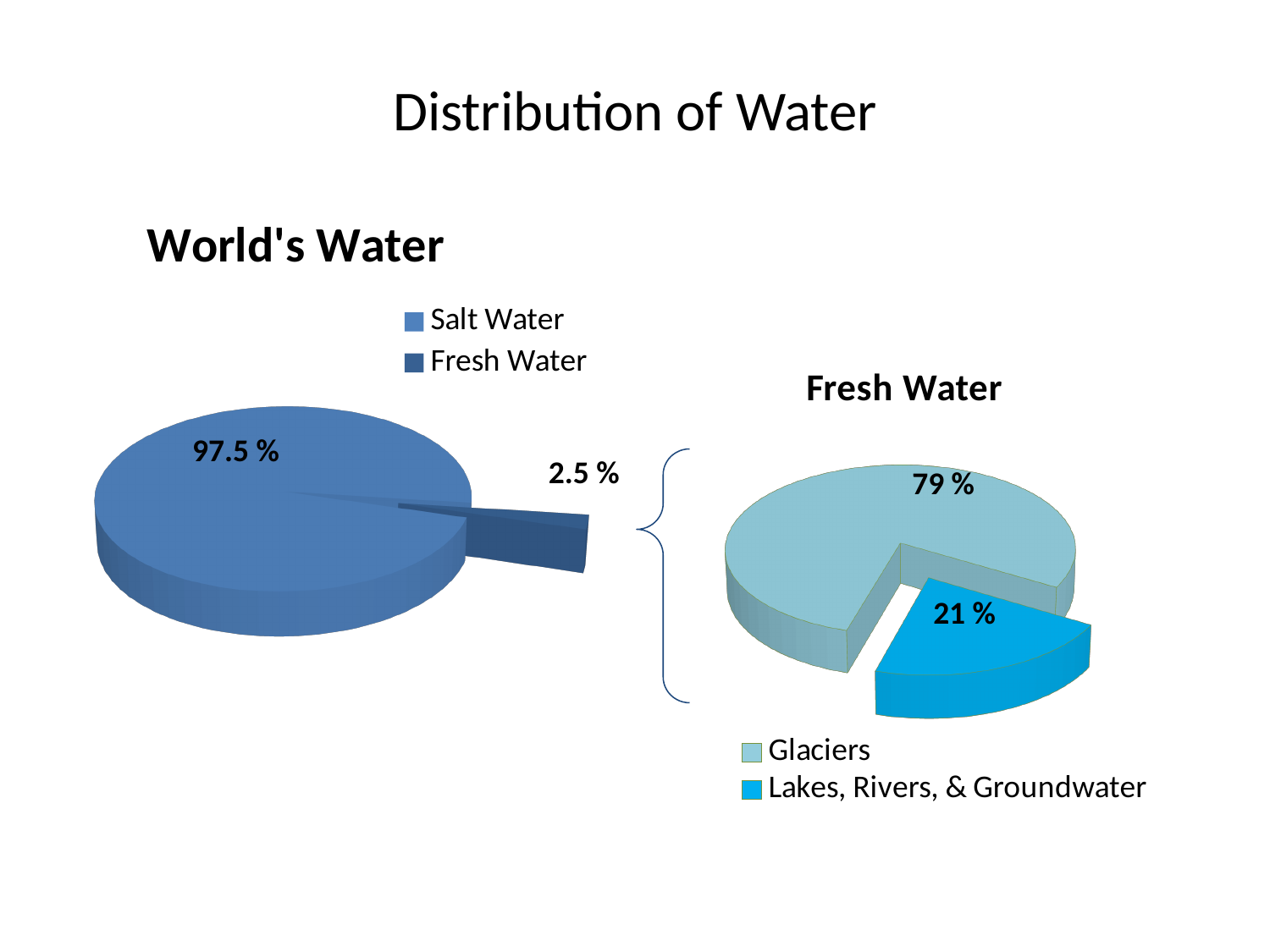
In the "Fresh Water" chart, which is larger: Glaciers or Lakes, Rivers, & Groundwater? Glaciers What kind of chart is the "World's Water" chart? Pie chart In the "Fresh Water" chart, what percentage is Lakes, Rivers, & Groundwater? 21 % In the "World's Water" chart, which category has the largest share? Salt Water In the "Fresh Water" chart, what is the difference between the Glaciers share and the Lakes, Rivers, & Groundwater share? 58 % What is the title of the chart on the left of the slide? World's Water In the "Fresh Water" chart, what percentage is Glaciers? 79 % In the "World's Water" chart, what percentage is Salt Water? 97.5 % In the "Fresh Water" chart, which category has the smallest share? Lakes, Rivers, & Groundwater How many categories does the legend of the "Fresh Water" chart list? 2 In the "World's Water" chart, what is the difference between the Salt Water share and the Fresh Water share? 95 % In the "World's Water" chart, what percentage is Fresh Water? 2.5 %